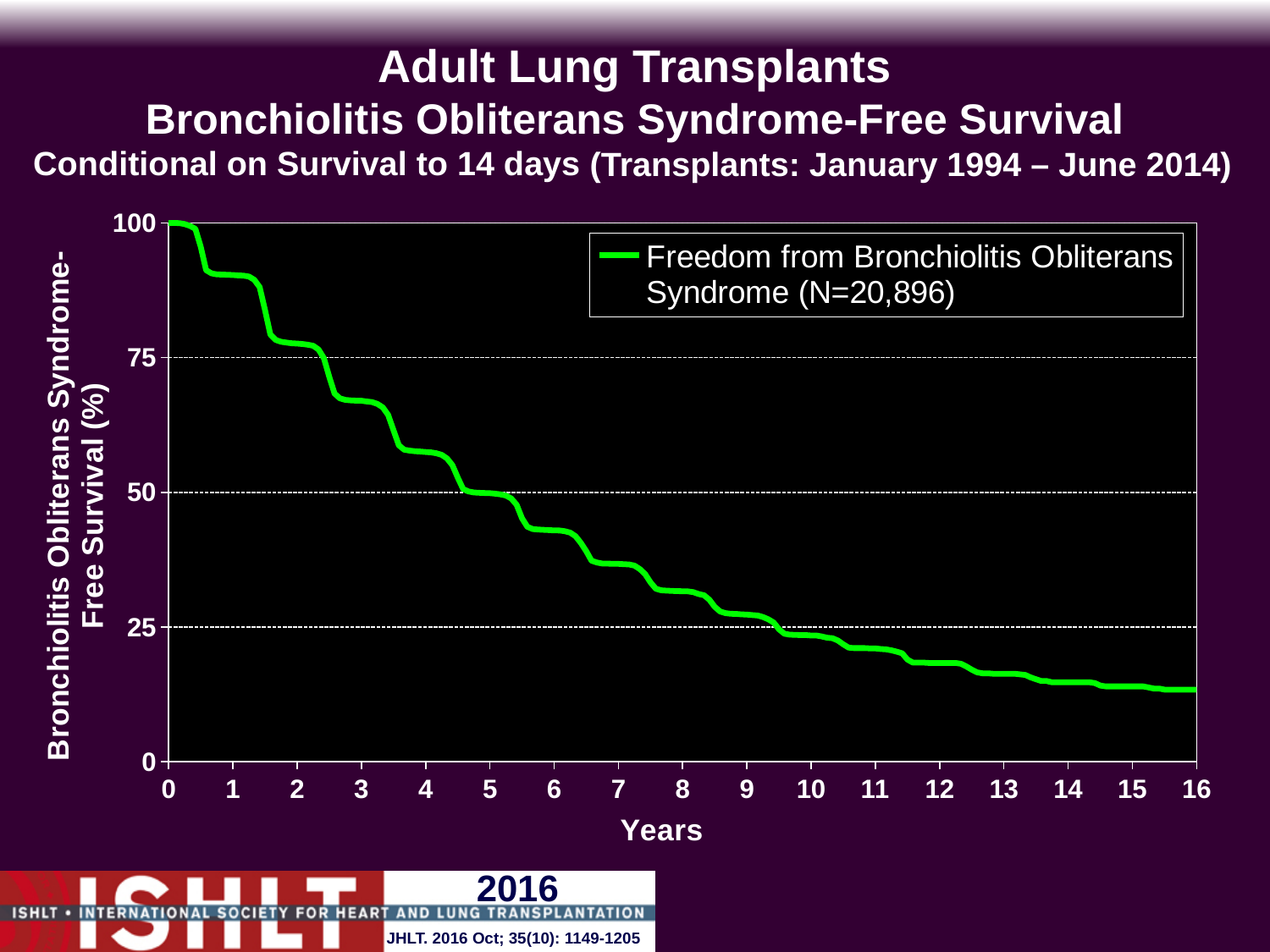
What is the BOS-free survival value at year 0? 100 Is the value at year 8 greater or less than 25? greater At which year on the x axis is the BOS-free survival highest? 0 What kind of chart is shown on the slide? line chart Is the value at year 12 greater or less than 25? less What sample size (N) is given in the legend? N=20,896 Is the value at year 1 greater or less than 75? greater Do the values rise or fall as the years increase along the x axis? fall Is the value at year 2 larger or smaller than the value at year 6? larger How many series does the legend list? 1